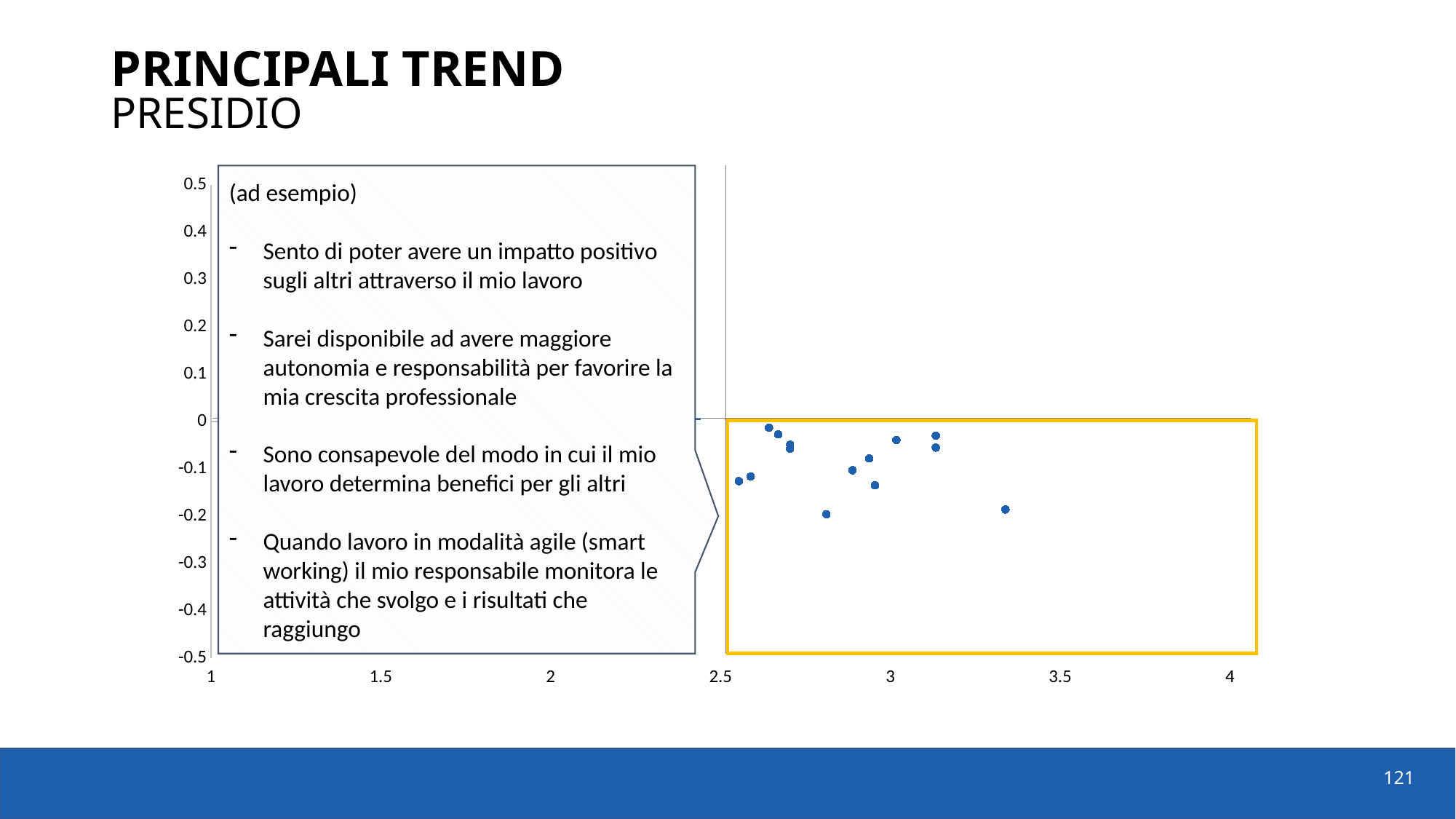
What is the highest value shown on the horizontal axis? 4 What kind of chart is shown on the slide? scatter chart Are the plotted points above or below -0.3 on the vertical axis? above What is the lowest value shown on the vertical axis? -0.5